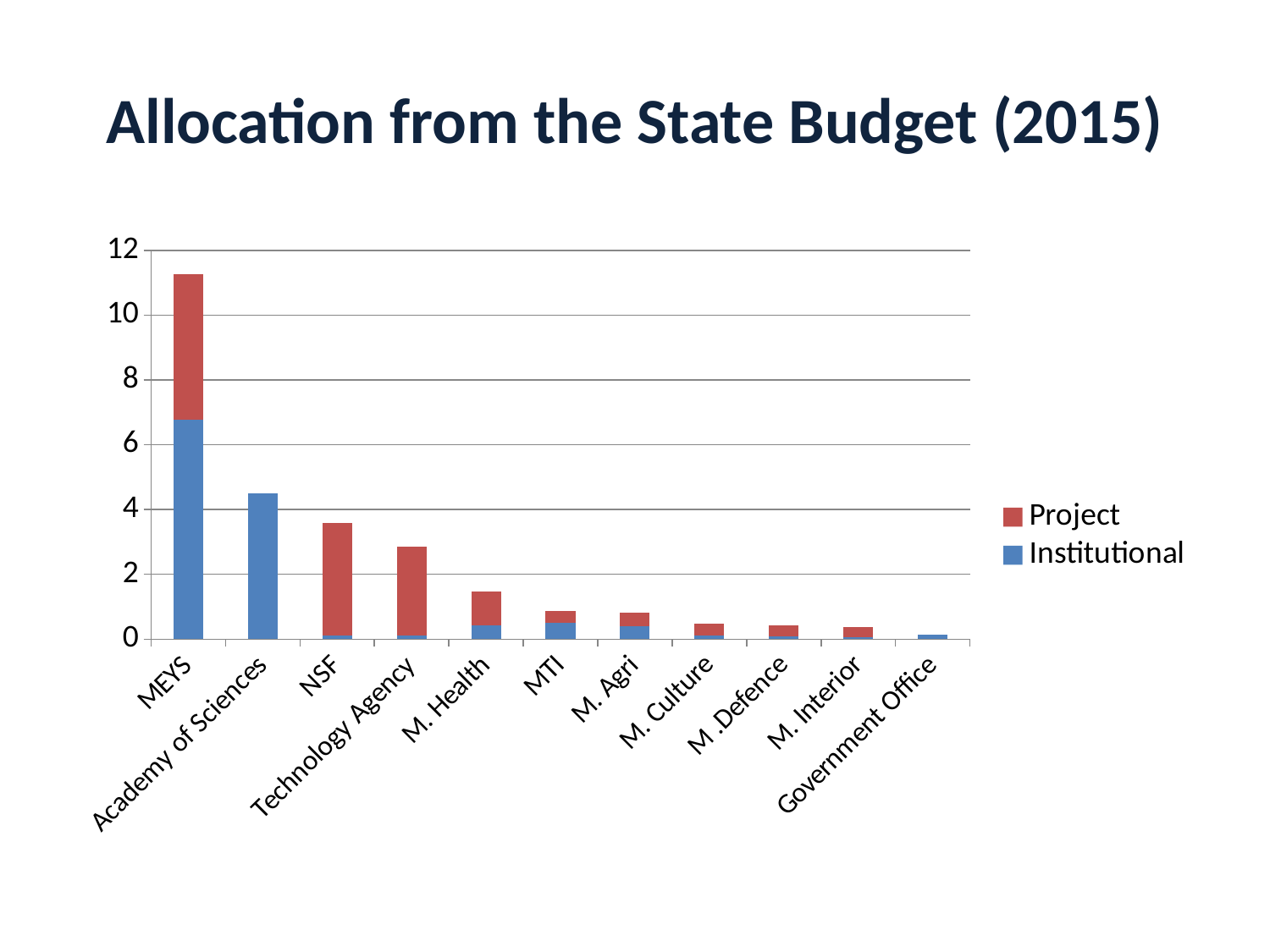
Is the total value for MEYS greater or less than 10? greater Is the total value for Technology Agency greater or less than 2? greater Is the total value for NSF greater or less than 4? less How many categories are shown on the x axis of the chart? 11 Which has a larger total bar, NSF or M. Health? NSF Do the total bar heights generally rise or fall from left to right along the x axis? fall How many series does the chart's legend list? 2 What is the title of the chart on the slide? Allocation from the State Budget (2015) Which category has the tallest total bar? MEYS Which category has the shortest total bar? Government Office What kind of chart is shown on the slide? stacked bar chart